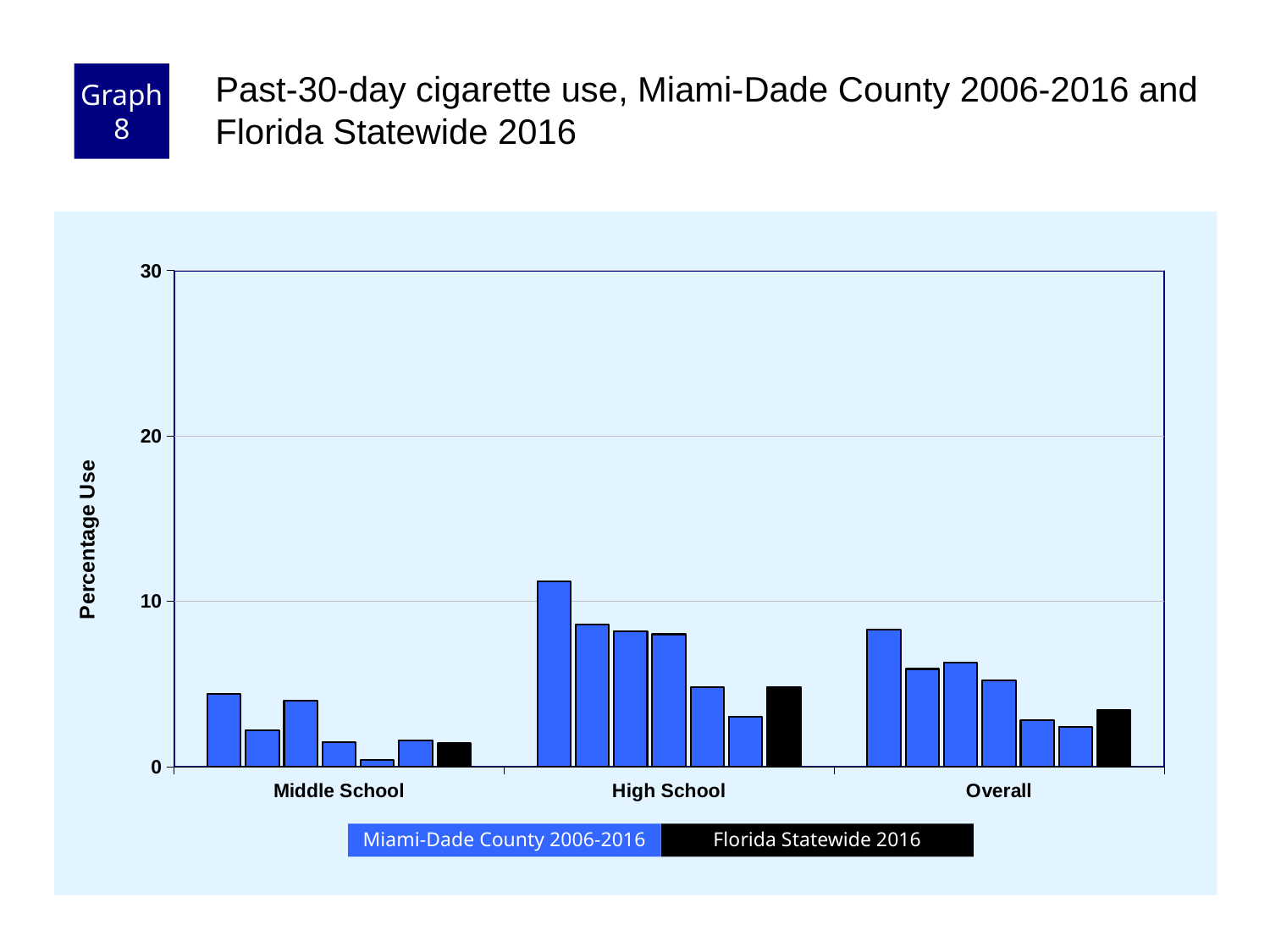
How many series does the legend list? 2 How many bars are plotted in the High School group? 7 Is the tallest bar in the Middle School group greater or less than 10? less Which category contains the tallest bar on the chart? High School Is the Florida Statewide 2016 value for High School greater or less than 10? less How many categories are shown on the x axis? 3 What kind of chart is shown on the slide? bar chart What is the label on the y axis? Percentage Use Is the tallest Miami-Dade County bar in the High School group greater or less than 10? greater Which series is shown in black in the legend? Florida Statewide 2016 Do the Miami-Dade County bars in the High School group rise or fall from left to right? fall Which is larger: the Florida Statewide 2016 bar for High School or the Florida Statewide 2016 bar for Middle School? High School